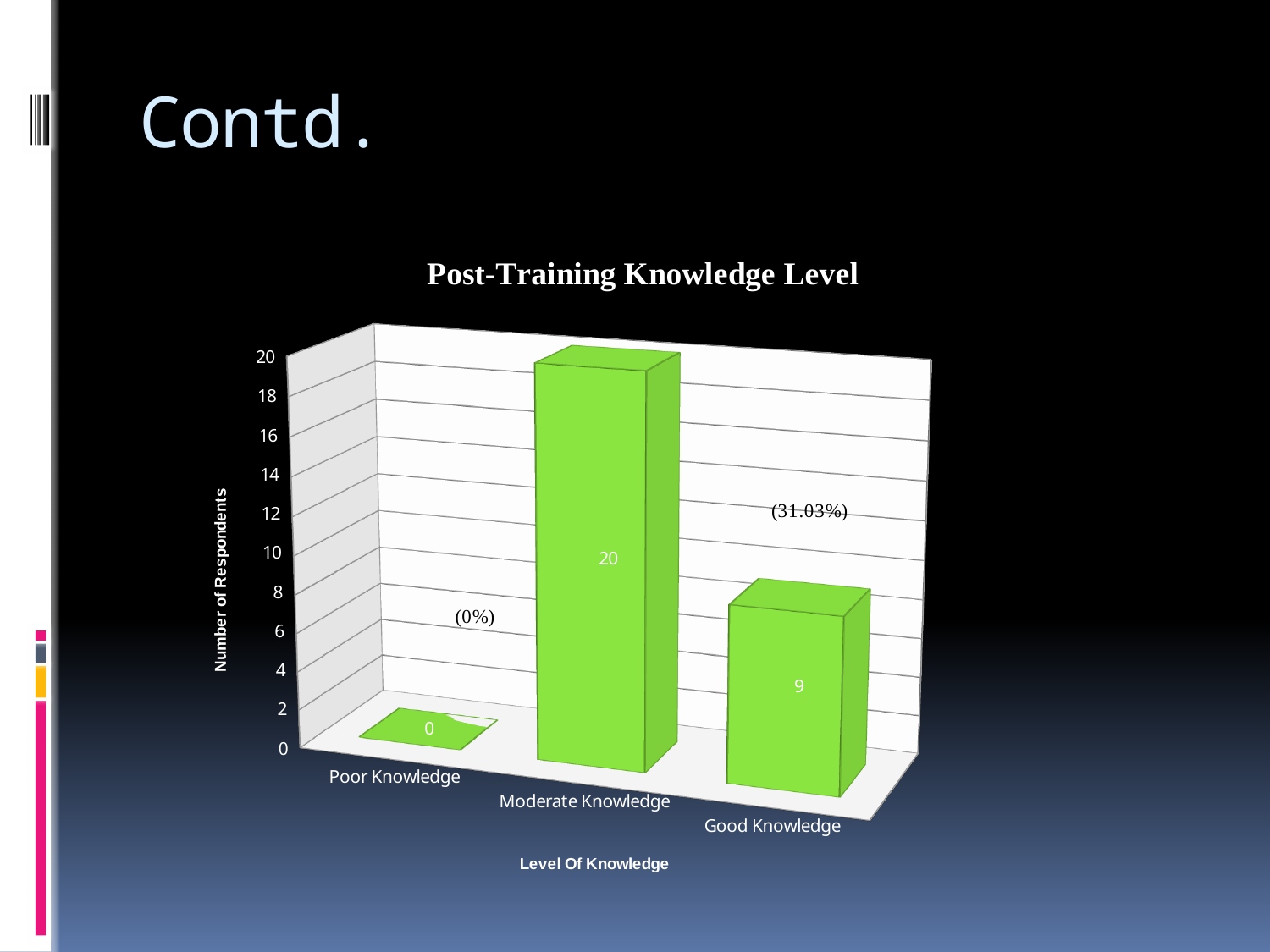
What kind of chart is shown on the slide? Bar chart Which level of knowledge has the lowest number of respondents? Poor Knowledge What percentage is printed above the Good Knowledge bar? (31.03%) What is the number of respondents with Good Knowledge? 9 Which has more respondents, Good Knowledge or Poor Knowledge? Good Knowledge What is the label of the vertical axis? Number of Respondents What is the title of the chart? Post-Training Knowledge Level What is the difference in number of respondents between Moderate Knowledge and Good Knowledge? 11 What is the number of respondents with Poor Knowledge? 0 Which level of knowledge has the highest number of respondents? Moderate Knowledge What is the number of respondents with Moderate Knowledge in the Post-Training Knowledge Level chart? 20 How many knowledge level categories are shown on the x axis? 3